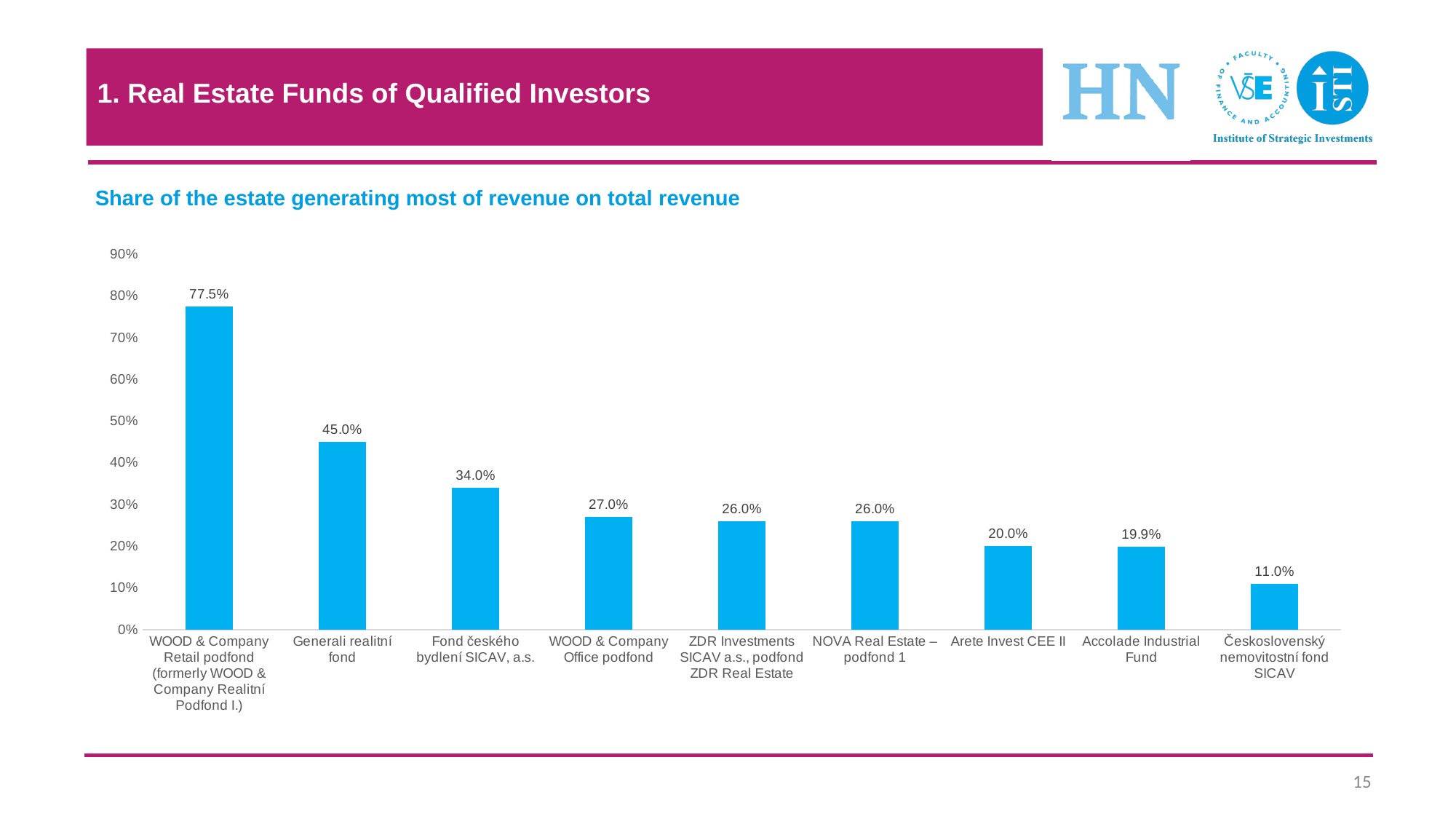
Which fund has the highest share? WOOD & Company Retail podfond (formerly WOOD & Company Realitní Podfond I.) What is the difference between the values for WOOD & Company Office podfond and Arete Invest CEE II? 7.0% Which fund has the lowest share? Československý nemovitostní fond SICAV How many funds are shown in the chart? 9 What is the value for Generali realitní fond? 45.0% What is the title of the chart? Share of the estate generating most of revenue on total revenue Is the value for Arete Invest CEE II greater or less than 30%? less What kind of chart is shown on the slide? Bar chart What is the value for Fond českého bydlení SICAV, a.s.? 34.0% What is the value for Accolade Industrial Fund? 19.9% Which is larger, the value for Fond českého bydlení SICAV, a.s. or the value for WOOD & Company Office podfond? Fond českého bydlení SICAV, a.s. What is the difference between the values for WOOD & Company Retail podfond and Generali realitní fond? 32.5%